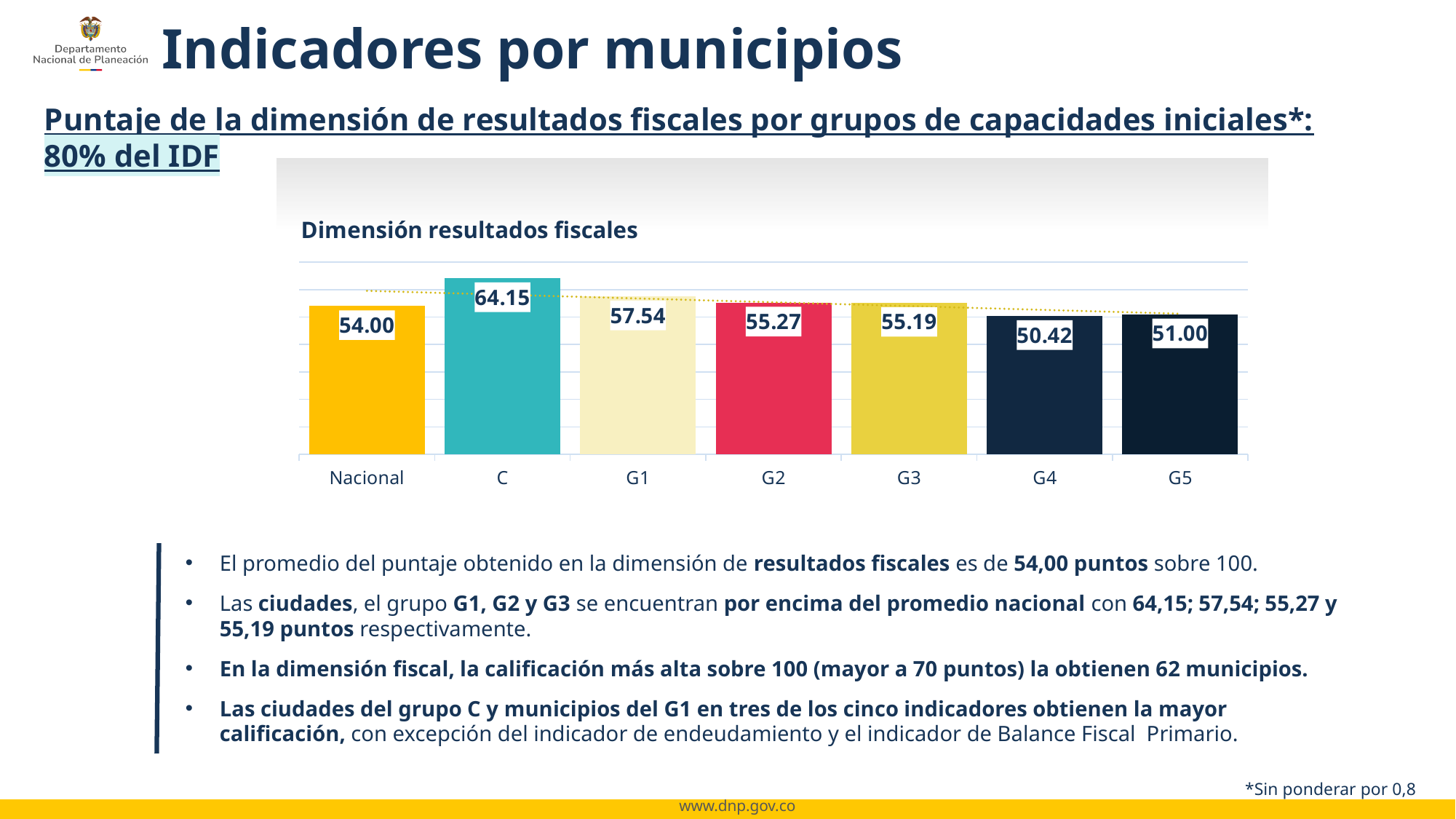
Which category has the lowest value in the chart? G4 What is the value for Nacional in the chart? 54.00 What is the value for G1 in the 'Dimensión resultados fiscales' chart? 57.54 What colour is the bar for G2? Red Which category has the highest value in the chart? C Which is larger, the value for G1 or the value for G5? G1 What is the value for G4 in the chart? 50.42 What kind of chart is shown on the slide? Bar chart How many categories are shown on the x axis of the chart? 7 What is the difference between the values for C and Nacional? 10.15 What is the difference between the values for G2 and G3? 0.08 What is the title of the chart? Dimensión resultados fiscales